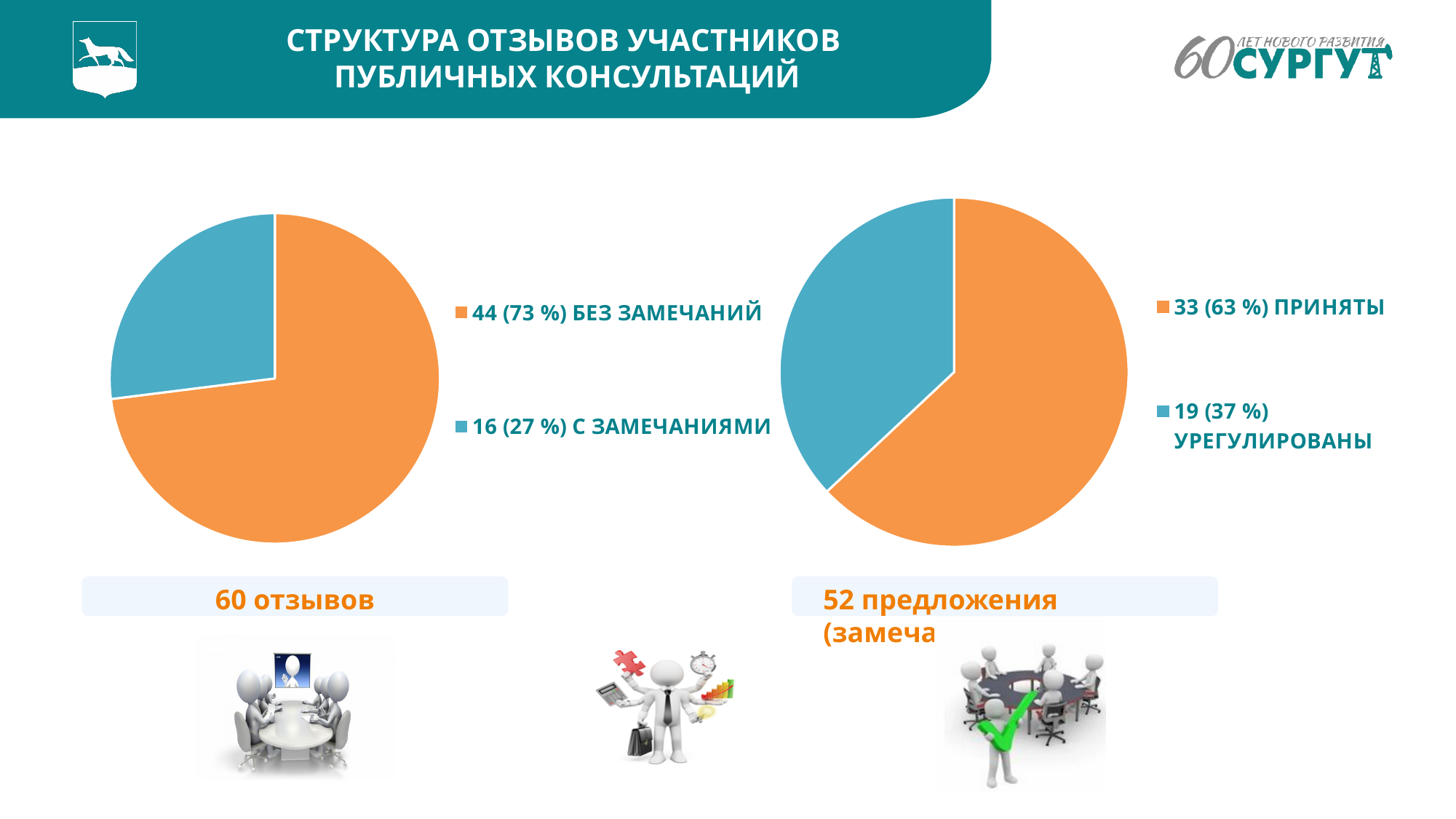
In the left pie chart, which category has the larger share? БЕЗ ЗАМЕЧАНИЙ In the right pie chart, what is the difference between the ПРИНЯТЫ and УРЕГУЛИРОВАНЫ counts? 14 What kind of chart is the left chart on the slide? pie chart In the right pie chart, what colour is the ПРИНЯТЫ slice? orange In the right pie chart, which category has the smaller share? УРЕГУЛИРОВАНЫ In the left pie chart, how many reviews are labelled С ЗАМЕЧАНИЯМИ? 16 (27 %) In the right pie chart, how many proposals are labelled УРЕГУЛИРОВАНЫ? 19 (37 %) In the right pie chart, how many proposals are labelled ПРИНЯТЫ? 33 (63 %) How many slices does the right pie chart have? 2 In the left pie chart, how many reviews are labelled БЕЗ ЗАМЕЧАНИЙ? 44 (73 %) In the left pie chart, what is the difference between the БЕЗ ЗАМЕЧАНИЙ and С ЗАМЕЧАНИЯМИ counts? 28 In the left pie chart, what share of the pie is С ЗАМЕЧАНИЯМИ? 27 %